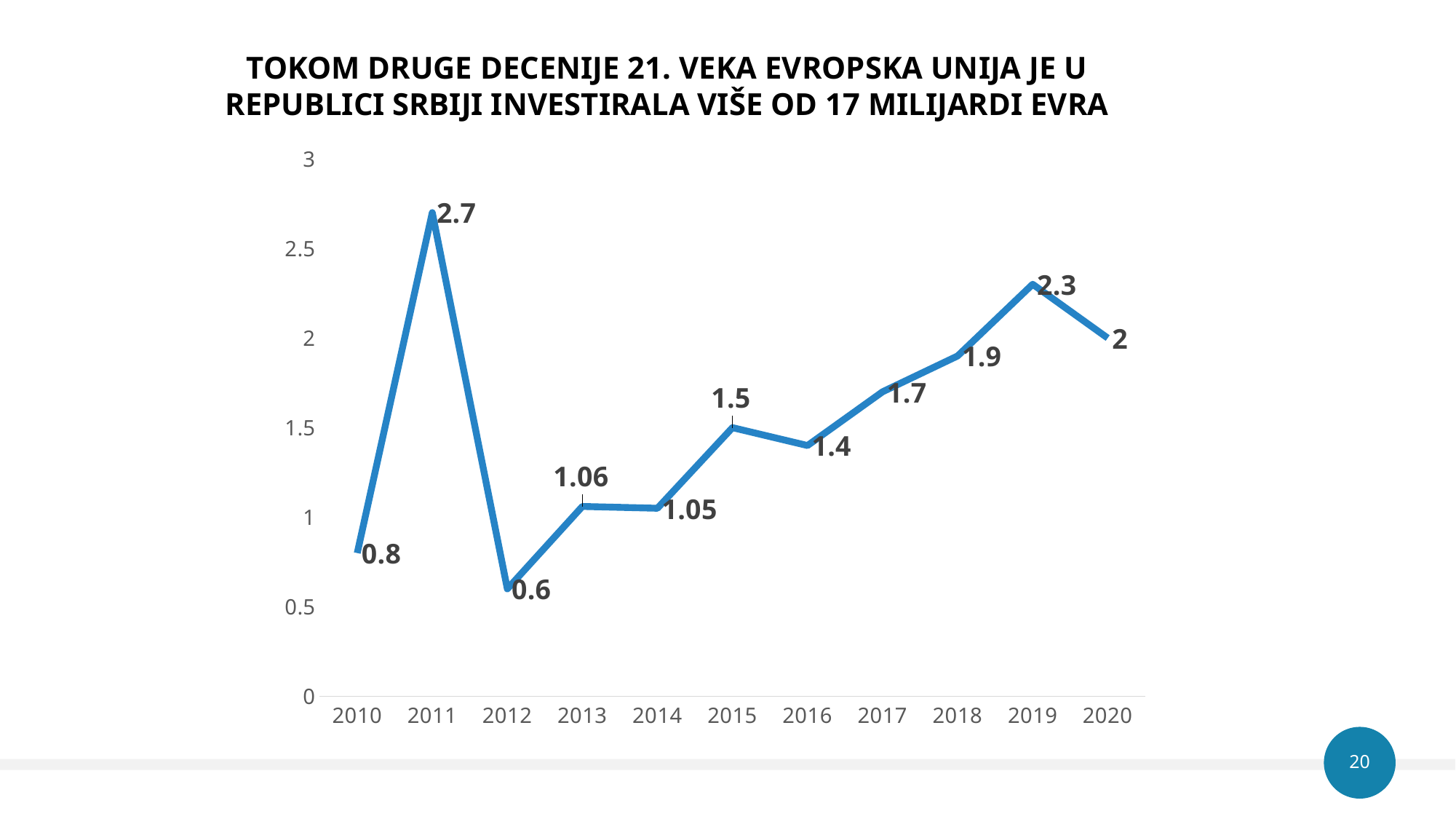
Which year has the highest value? 2011 What is the difference between the values for 2015 and 2014? 0.45 Do the values rise or fall from 2016 to 2019? rise Is the value for 2016 greater or less than 1.5? less What is the value for 2013? 1.06 Which year has the lowest value? 2012 What is the difference between the values for 2011 and 2012? 2.1 Which is larger, the value for 2019 or the value for 2020? 2019 How many years are shown on the x axis? 11 What is the value for 2011? 2.7 What is the value for 2020? 2 What kind of chart is shown on the slide? line chart